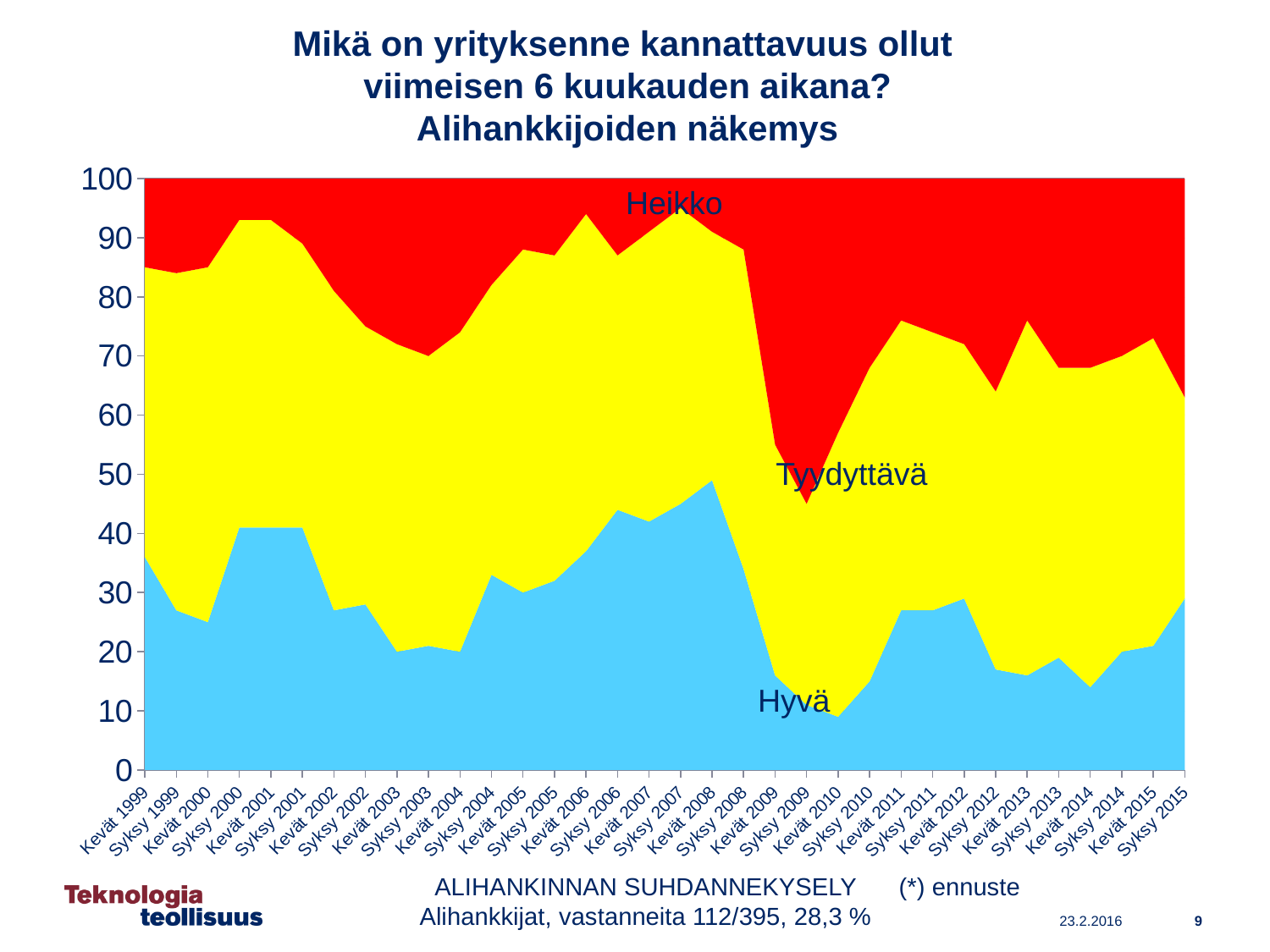
Is the combined value of Hyvä and Tyydyttävä at Syksy 2009 greater or less than 50? less How many series are labelled in the chart? 3 Which series occupies the bottom band of the chart? Hyvä Is the combined value of Hyvä and Tyydyttävä at Kevät 2001 greater or less than 90? greater Does the Hyvä band rise or fall from Kevät 2008 to Syksy 2010? fall Which series is shown in red? Heikko Is the value for Hyvä at Kevät 1999 greater or less than 30? greater What kind of chart is shown on the slide? Area chart How many time points are shown on the x axis? 34 Which is larger at Syksy 2009, the Hyvä band or the Heikko band? Heikko